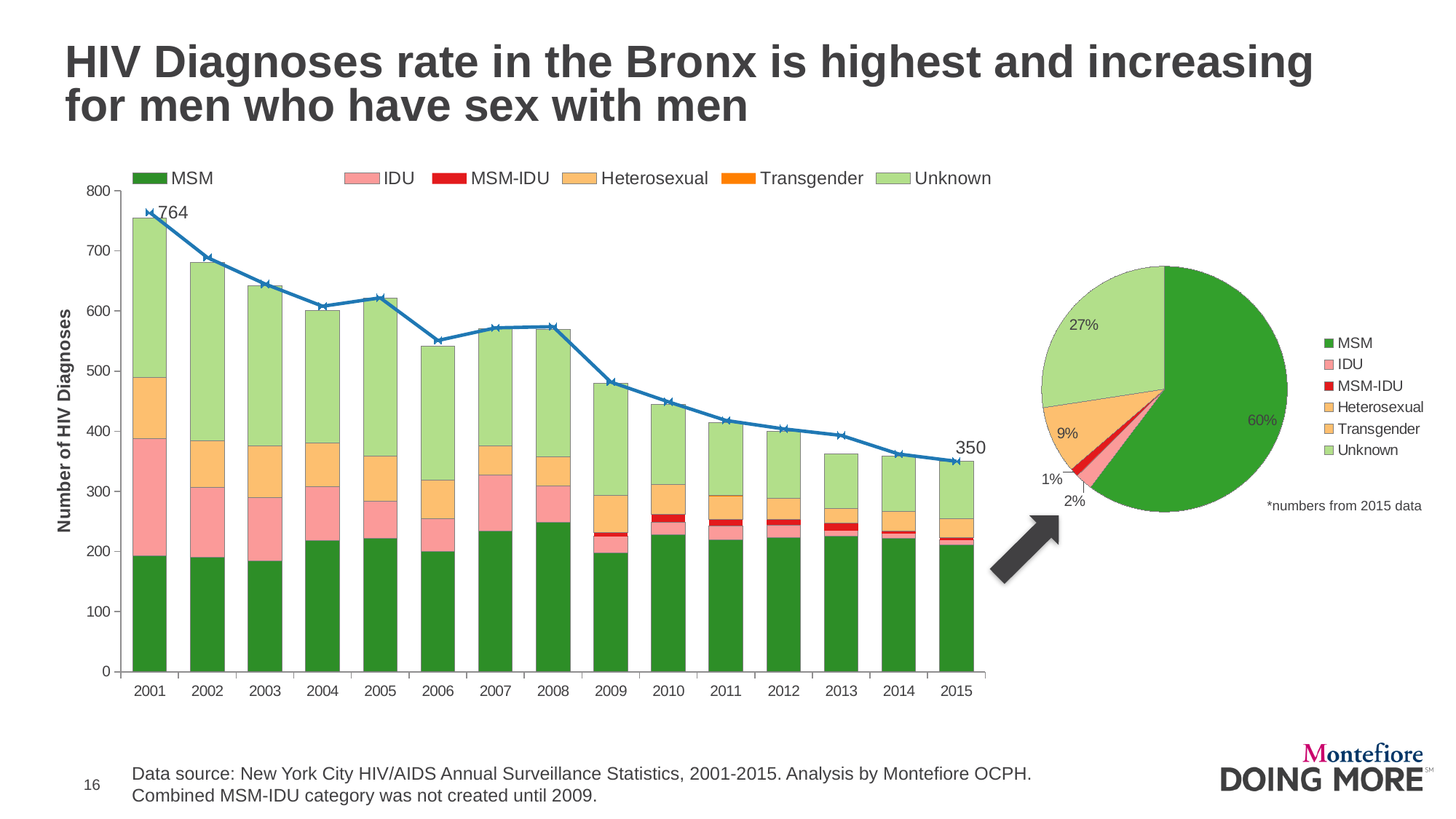
On the bar chart on the left, does the total number of HIV diagnoses generally rise or fall from 2001 to 2015? fall On the bar chart on the left, what is the labelled total number of HIV diagnoses in 2001? 764 On the bar chart on the left, how many series does the legend list? 6 On the bar chart on the left, is the total number of HIV diagnoses in 2009 greater or less than 400? greater On the pie chart on the right, what share of HIV diagnoses is MSM? 60% On the bar chart on the left, how many years are shown on the x axis? 15 On the pie chart on the right, which category has the largest slice? MSM On the bar chart on the left, what is the difference between the labelled totals for 2001 and 2015? 414 On the pie chart on the right, what share of HIV diagnoses is Unknown? 27% On the bar chart on the left, what is the labelled total number of HIV diagnoses in 2015? 350 On the bar chart on the left, is the total number of HIV diagnoses in 2013 greater or less than 400? less On the pie chart on the right, which year's data does the chart show, according to the note beside it? 2015